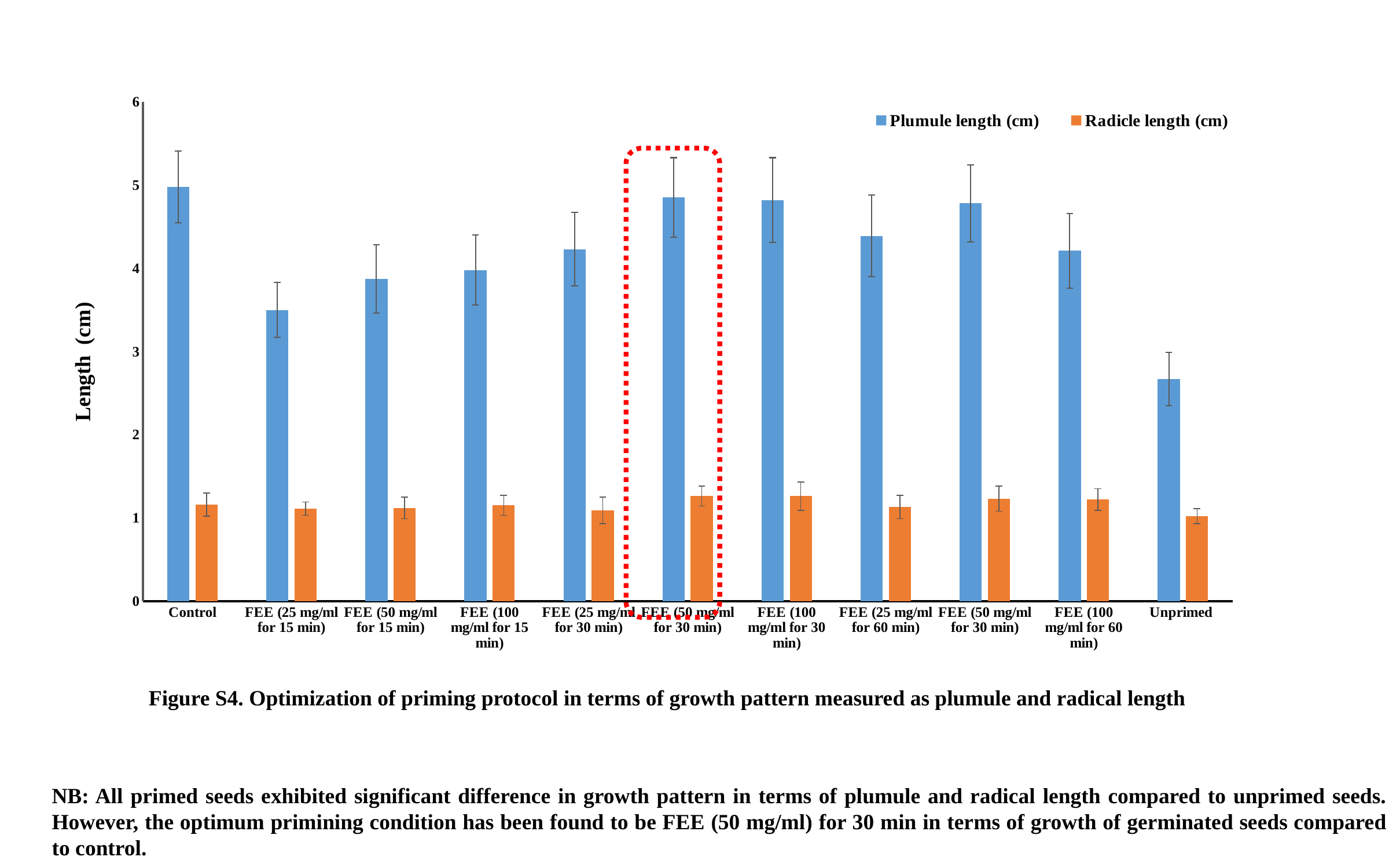
Is the plumule length for FEE (25 mg/ml for 15 min) greater or less than 4? less Which is larger for Control, the plumule length or the radicle length? Plumule length Is the plumule length for Unprimed greater or less than 3? less What is the title of the y axis? Length (cm) Which category has the highest plumule length? Control What kind of chart is shown on the slide? bar chart Which is larger, the plumule length for FEE (25 mg/ml for 15 min) or for FEE (25 mg/ml for 30 min)? FEE (25 mg/ml for 30 min) Is the plumule length for Control greater or less than 4? greater Which category has the lowest plumule length? Unprimed How many categories are shown along the x axis? 11 How many series does the legend list? 2 Which category is highlighted with a red dotted box? FEE (50 mg/ml for 30 min)